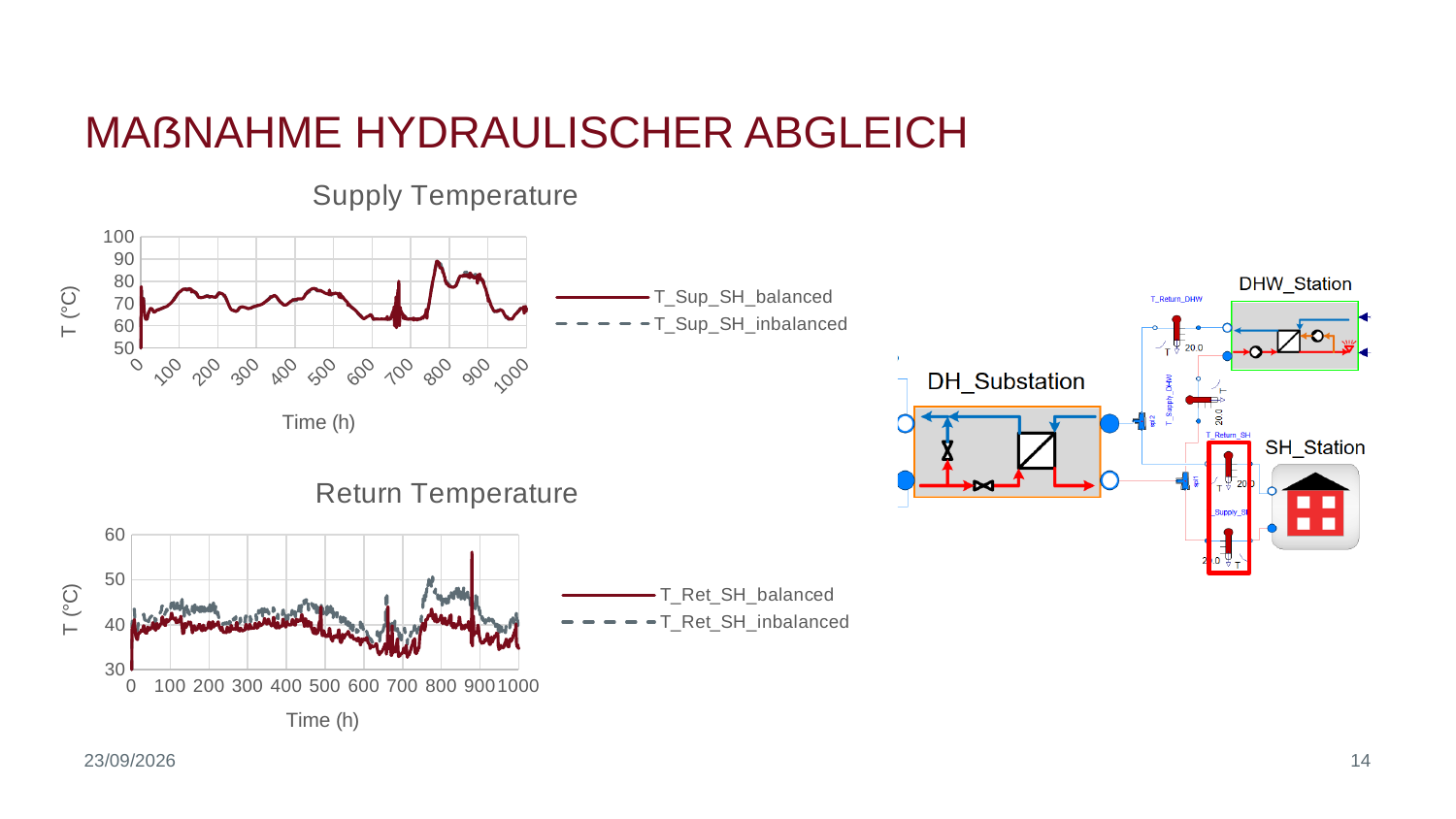
What kind of chart is the Supply Temperature chart? line chart In the Supply Temperature chart, is the value of T_Sup_SH_balanced at around 600 h greater or less than 70? less In the Return Temperature chart, is the value of T_Ret_SH_balanced at around 800 h greater or less than 50? less In the Return Temperature chart, which series is generally higher over the time range, T_Ret_SH_balanced or T_Ret_SH_inbalanced? T_Ret_SH_inbalanced What is the x-axis title of the Supply Temperature chart? Time (h) How many series does the legend of the Return Temperature chart list? 2 In the Supply Temperature chart, is the value of T_Sup_SH_balanced at around 100 h greater or less than 70? greater How many series does the legend of the Supply Temperature chart list? 2 What kind of chart is the Return Temperature chart? line chart In the Return Temperature chart, which series is drawn with a dashed line? T_Ret_SH_inbalanced